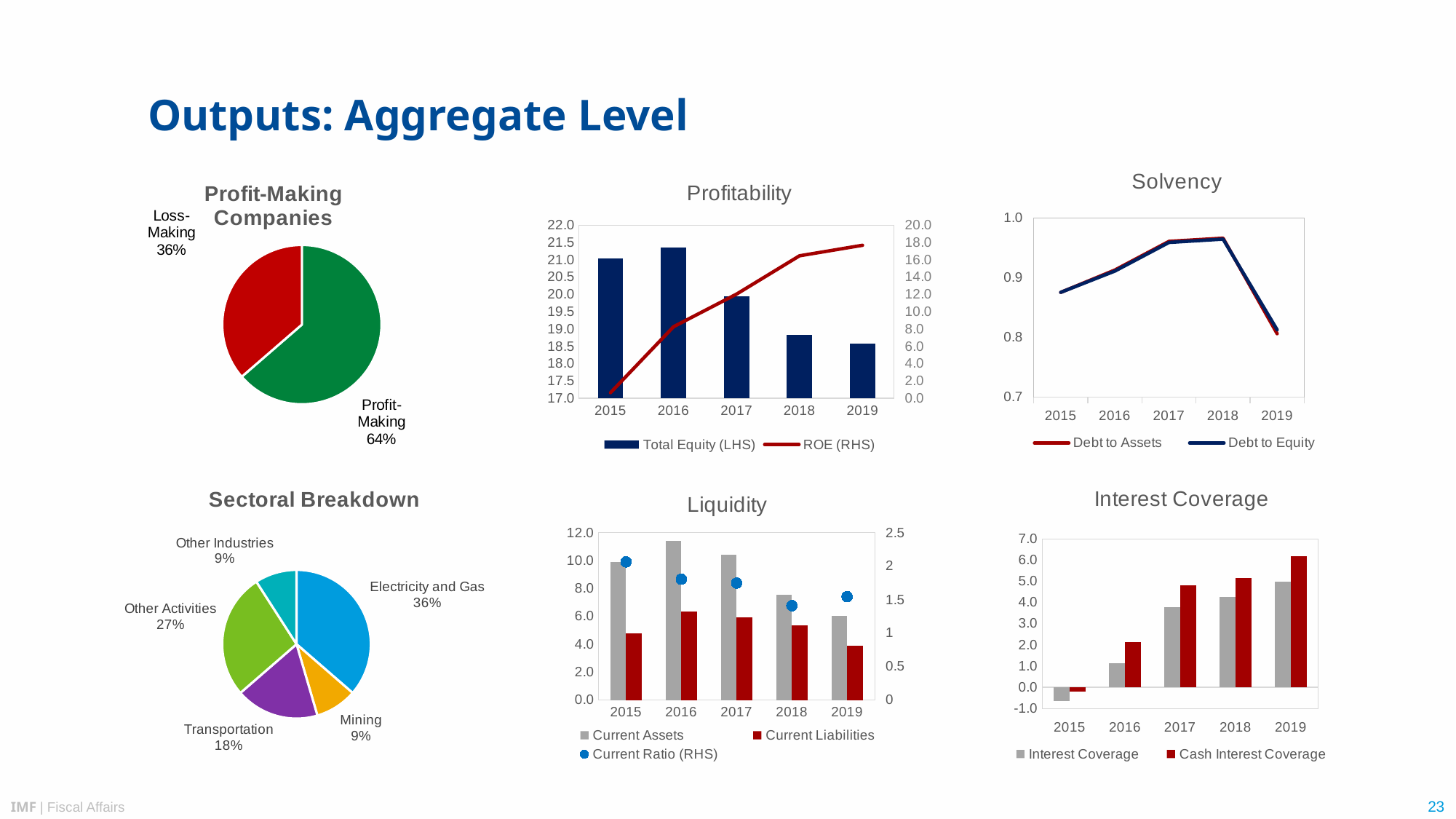
In the Interest Coverage chart, is the Cash Interest Coverage value for 2019 greater or less than 5.0? greater In the Solvency chart, is the Debt to Assets value for 2019 greater or less than 0.9? less In the Profitability chart, does ROE (RHS) rise or fall from 2015 to 2019? rise In the Sectoral Breakdown pie chart, what is the share for Transportation? 18% In the Profit-Making Companies pie chart, what share of companies are loss-making? 36% In the Sectoral Breakdown pie chart, what is the difference between the shares of Other Activities and Mining? 18% In the Profit-Making Companies pie chart, what share of companies are profit-making? 64% In the Solvency chart, how many series does the legend list? 2 In the Profitability chart, which year has the highest Total Equity (LHS) bar? 2016 In the Sectoral Breakdown pie chart, how many sectors are shown? 5 In the Liquidity chart, which year has the highest Current Assets bar? 2016 In the Sectoral Breakdown pie chart, which sector has the largest share? Electricity and Gas